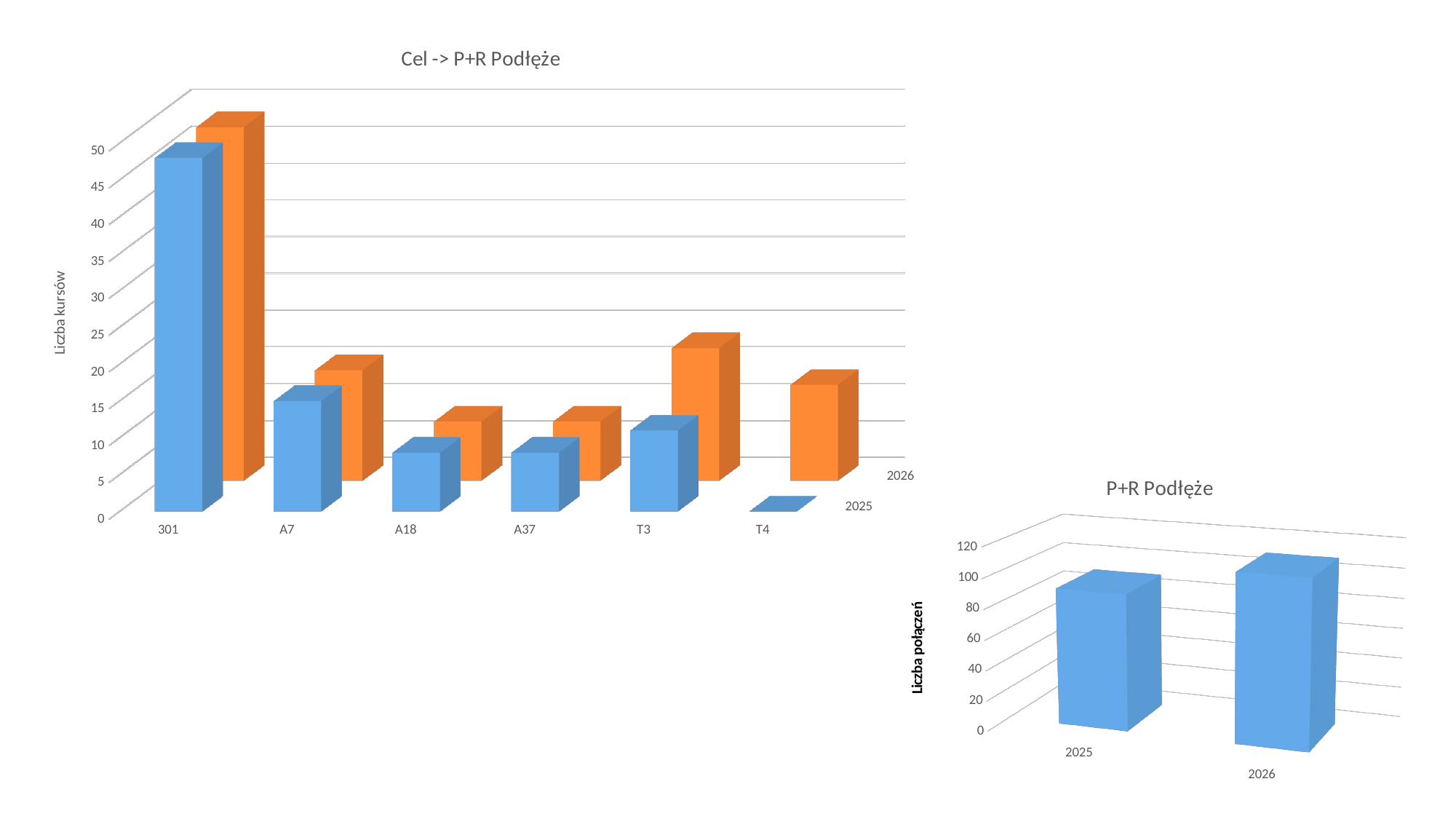
On the chart titled "Cel -> P+R Podłęże", is the 2025 value for 301 greater or less than 40? greater On the chart titled "P+R Podłęże", which is larger: 2025 or 2026? 2026 On the chart titled "Cel -> P+R Podłęże", which category has the lowest value for 2025? T4 On the chart titled "Cel -> P+R Podłęże", which category has the highest value for 2026? 301 On the chart titled "Cel -> P+R Podłęże", how many series are plotted? 2 On the chart titled "Cel -> P+R Podłęże", which is larger for 2025: 301 or A7? 301 On the chart titled "Cel -> P+R Podłęże", is the 2025 value for A18 greater or less than 20? less On the chart titled "P+R Podłęże", is the value for 2025 greater or less than 40? greater On the chart titled "Cel -> P+R Podłęże", which category has the highest value for 2025? 301 What kind of chart is the chart titled "P+R Podłęże" on the right of the slide? bar chart On the chart titled "Cel -> P+R Podłęże", what is the label of the vertical axis? Liczba kursów On the chart titled "Cel -> P+R Podłęże", how many categories are shown on the x axis? 6